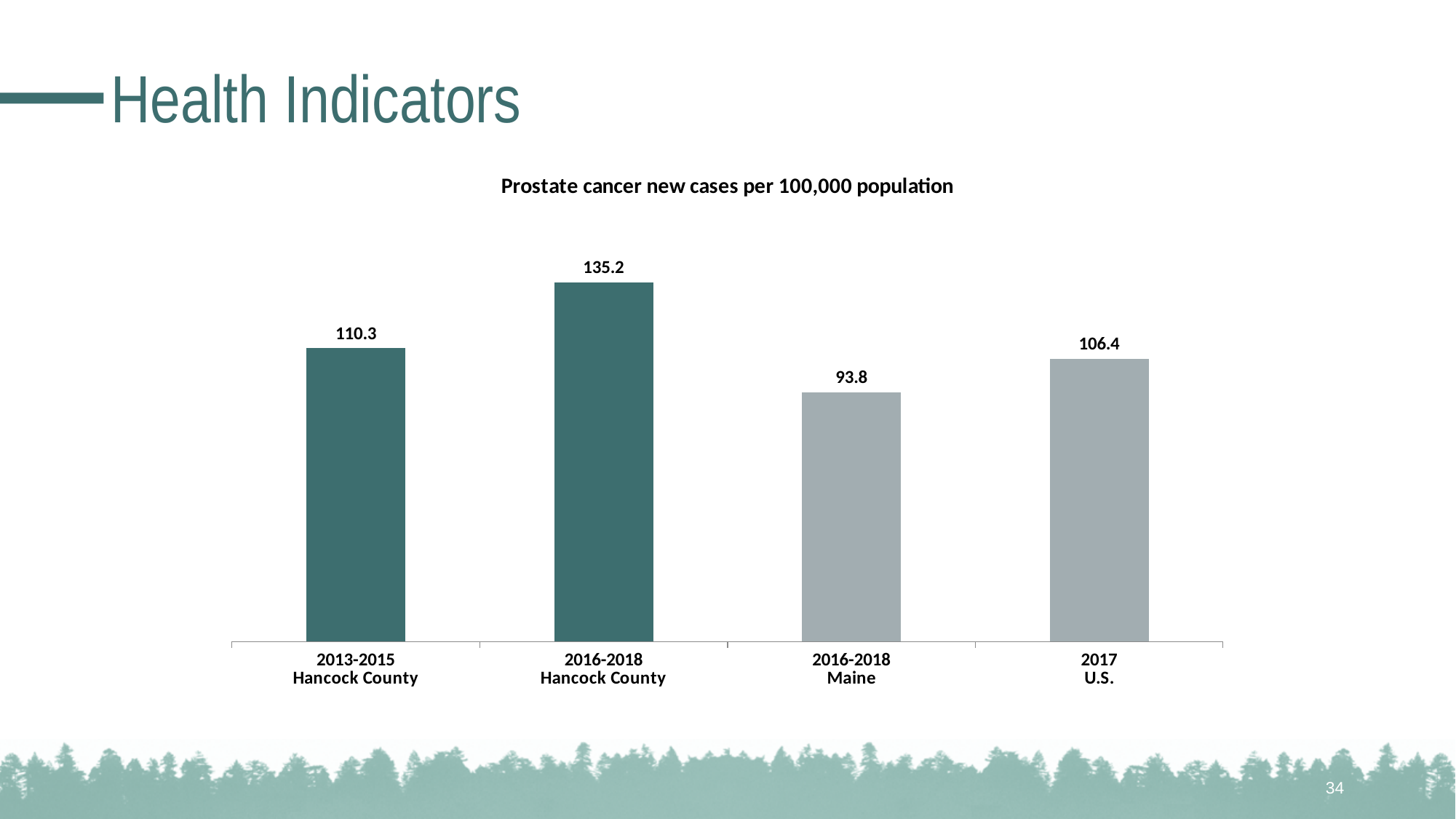
What is the title of the chart? Prostate cancer new cases per 100,000 population What is the value for 2017 U.S.? 106.4 What is the value for 2013-2015 Hancock County? 110.3 What is the difference between the 2016-2018 Hancock County value and the 2016-2018 Maine value? 41.4 Which is larger, the value for 2013-2015 Hancock County or the value for 2017 U.S.? 2013-2015 Hancock County What kind of chart is shown on the slide? Bar chart What is the value for 2016-2018 Maine? 93.8 What is the value for 2016-2018 Hancock County? 135.2 How many bars are shown in the chart? 4 Which category has the highest value? 2016-2018 Hancock County What is the difference between the 2016-2018 Hancock County value and the 2013-2015 Hancock County value? 24.9 Which category has the lowest value? 2016-2018 Maine